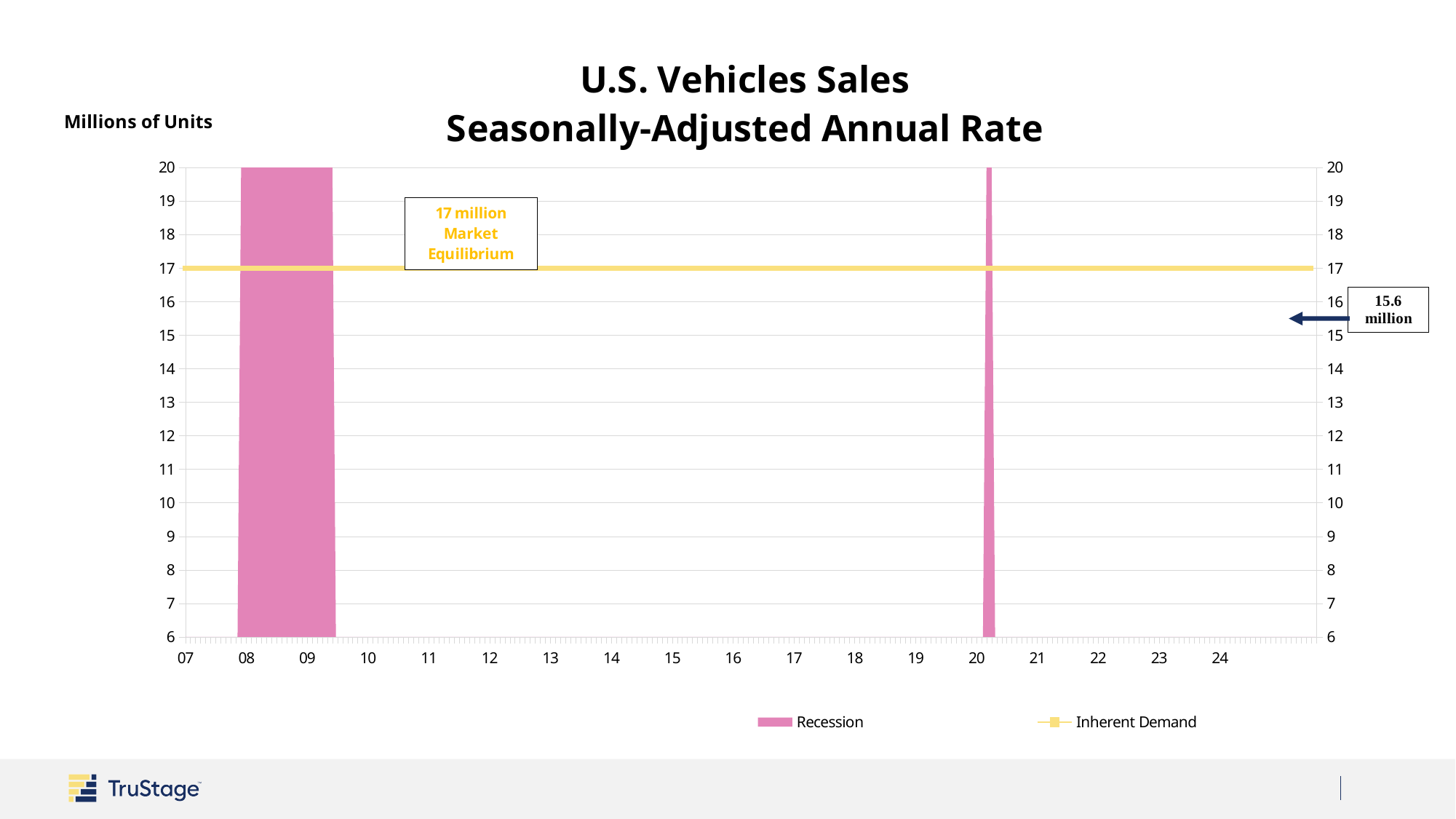
What is the difference between the 17 million Market Equilibrium and the 15.6 million value? 1.4 million Which is larger, the Inherent Demand level or the 15.6 million value indicated by the arrow? Inherent Demand What value does the arrow annotation at the right edge of the chart point to? 15.6 million Is the Inherent Demand line greater or less than 15? greater How many series does the legend list? 2 How many recession periods are shaded on the chart? 2 What is the title of the chart? U.S. Vehicles Sales Seasonally-Adjusted Annual Rate At what level does the Inherent Demand line sit on the y axis? 17 What value does the Market Equilibrium annotation give? 17 million Does the Inherent Demand line rise, fall, or stay flat across the x axis? stay flat What unit is shown for the y axis? Millions of Units